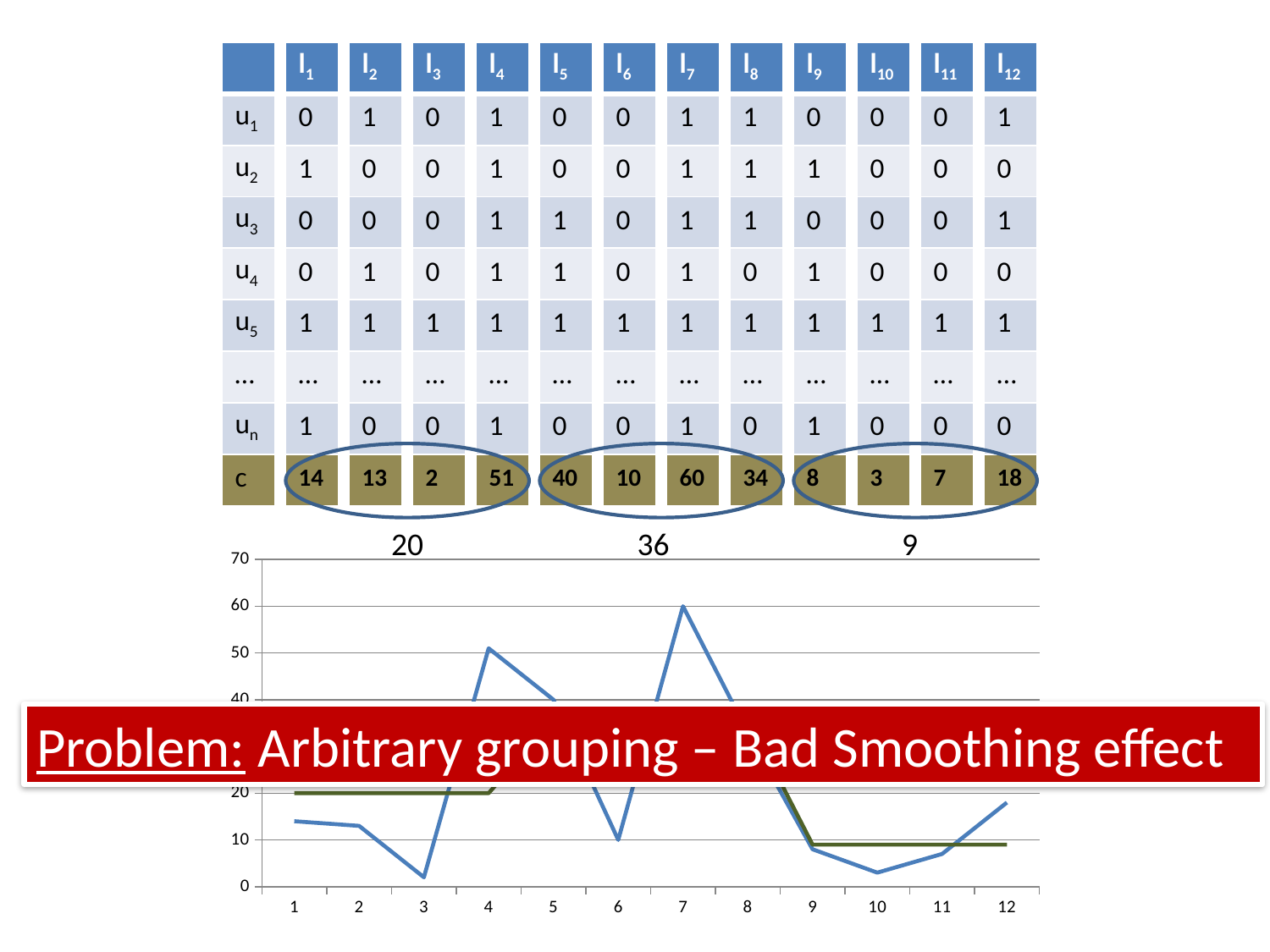
Does the blue line rise or fall from x = 10 to x = 12? rise Is the value of the blue line at x = 7 greater or less than 50? greater What is the value of the blue line at x = 4 (the c value for I4)? 51 What is the value of the blue line at x = 7 (the c value for I7)? 60 How many points are plotted along the x axis of the line chart? 12 Which has the larger value on the blue line, x = 4 or x = 5? 4 What is the value of the green line over positions 9 to 12? 9 Is the value of the blue line at x = 3 greater or less than 10? less What kind of chart is shown at the bottom of the slide? line chart At which x-axis position does the blue line reach its lowest value? 3 What is the difference between the blue line's values at x = 7 and x = 4? 9 At which x-axis position does the blue line reach its highest value? 7